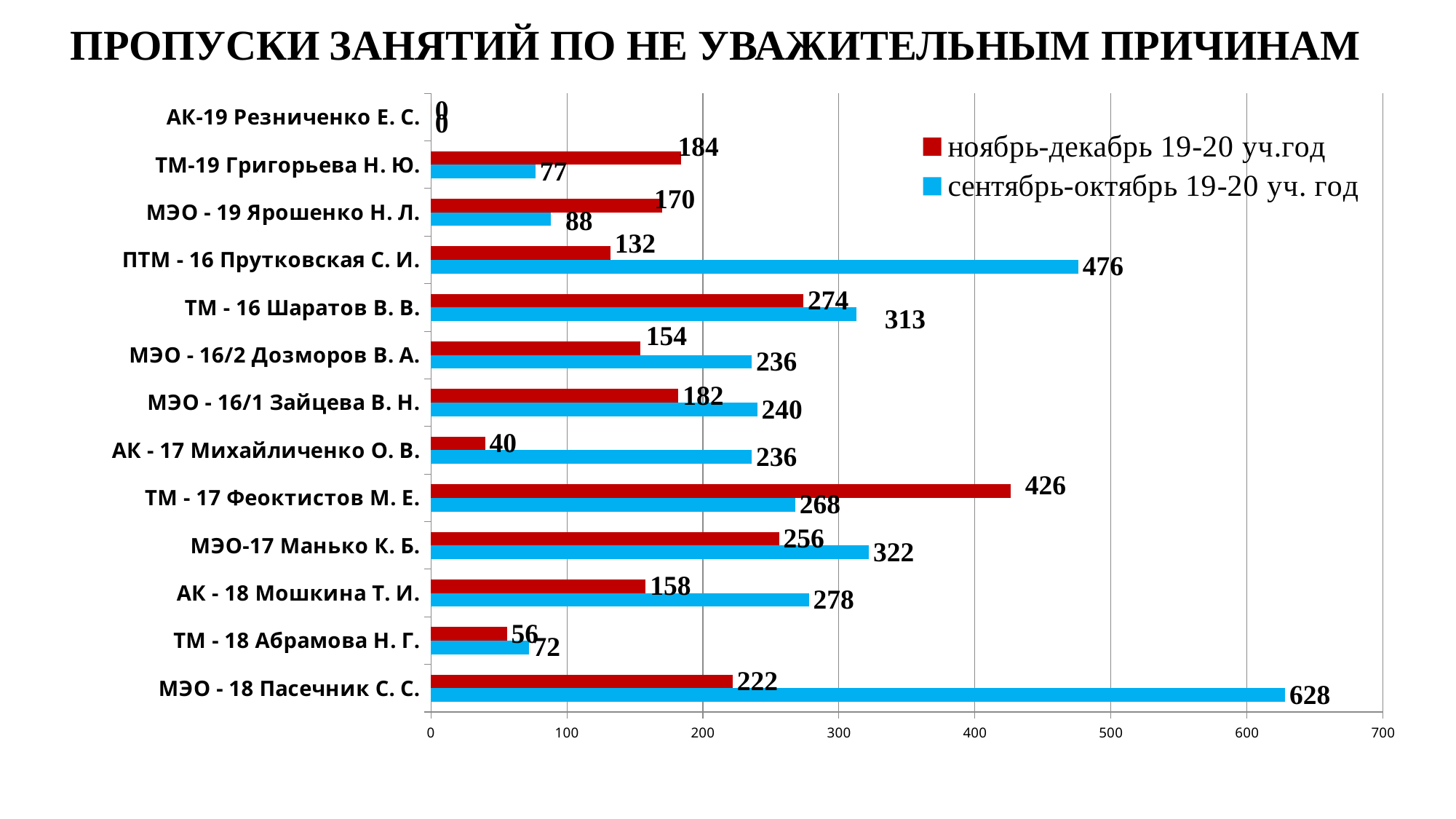
What is the title of the chart? ПРОПУСКИ ЗАНЯТИЙ ПО НЕ УВАЖИТЕЛЬНЫМ ПРИЧИНАМ How many series does the legend list? 2 How many categories (groups) are shown on the chart? 13 For АК - 17 Михайличенко О. В., which series has the larger value: ноябрь-декабрь 19-20 уч.год or сентябрь-октябрь 19-20 уч. год? сентябрь-октябрь 19-20 уч. год What is the value for МЭО - 18 Пасечник С. С. in the сентябрь-октябрь 19-20 уч. год series? 628 What is the value for ТМ - 17 Феоктистов М. Е. in the ноябрь-декабрь 19-20 уч.год series? 426 What type of chart is shown on the slide? bar chart Which category has the lowest value in the ноябрь-декабрь 19-20 уч.год series? АК-19 Резниченко Е. С. What is the difference between the сентябрь-октябрь and ноябрь-декабрь values for ПТМ - 16 Прутковская С. И.? 344 Is the value for МЭО-17 Манько К. Б. in the сентябрь-октябрь 19-20 уч. год series greater or less than 300? greater Which category has the highest value in the сентябрь-октябрь 19-20 уч. год series? МЭО - 18 Пасечник С. С. Which category has the highest value in the ноябрь-декабрь 19-20 уч.год series? ТМ - 17 Феоктистов М. Е.